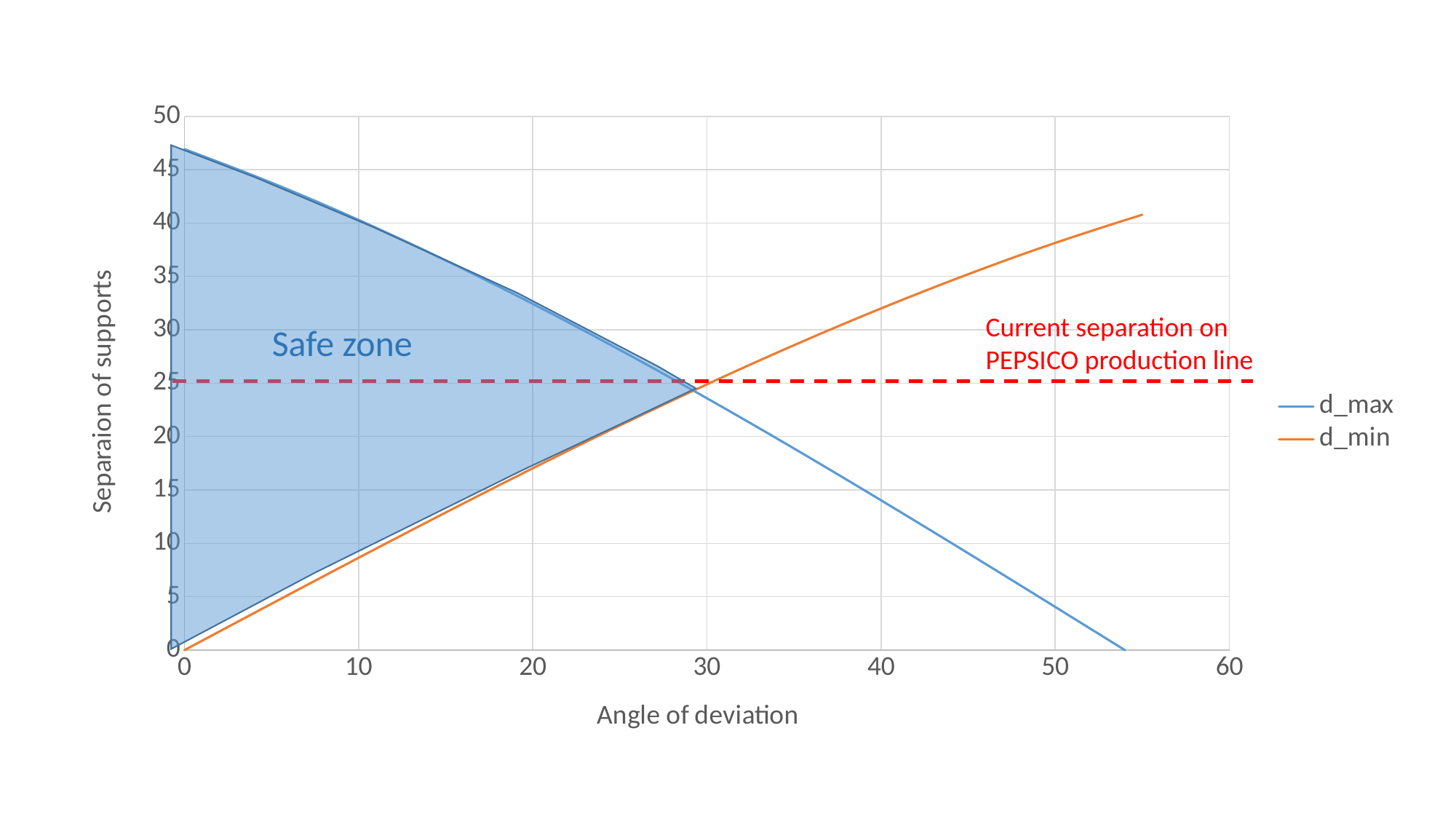
What is the value of d_min at an angle of deviation of 0? 0 How many series does the legend list? 2 Is the value of d_max at an angle of deviation of 40 greater or less than 20? less What are the names of the two series in the legend? d_max and d_min Does the d_min series rise or fall as the angle of deviation increases? rise At an angle of deviation of 40, which series has the larger value, d_max or d_min? d_min Is the value of d_min at an angle of deviation of 50 greater or less than 35? greater What is the title of the x axis? Angle of deviation At what value on the y axis is the red dashed line for the current separation on the PEPSICO production line drawn? 25 Is the value of d_max at an angle of deviation of 20 greater or less than 30? greater What kind of chart is shown on the slide? line chart Does the d_max series rise or fall as the angle of deviation increases? fall